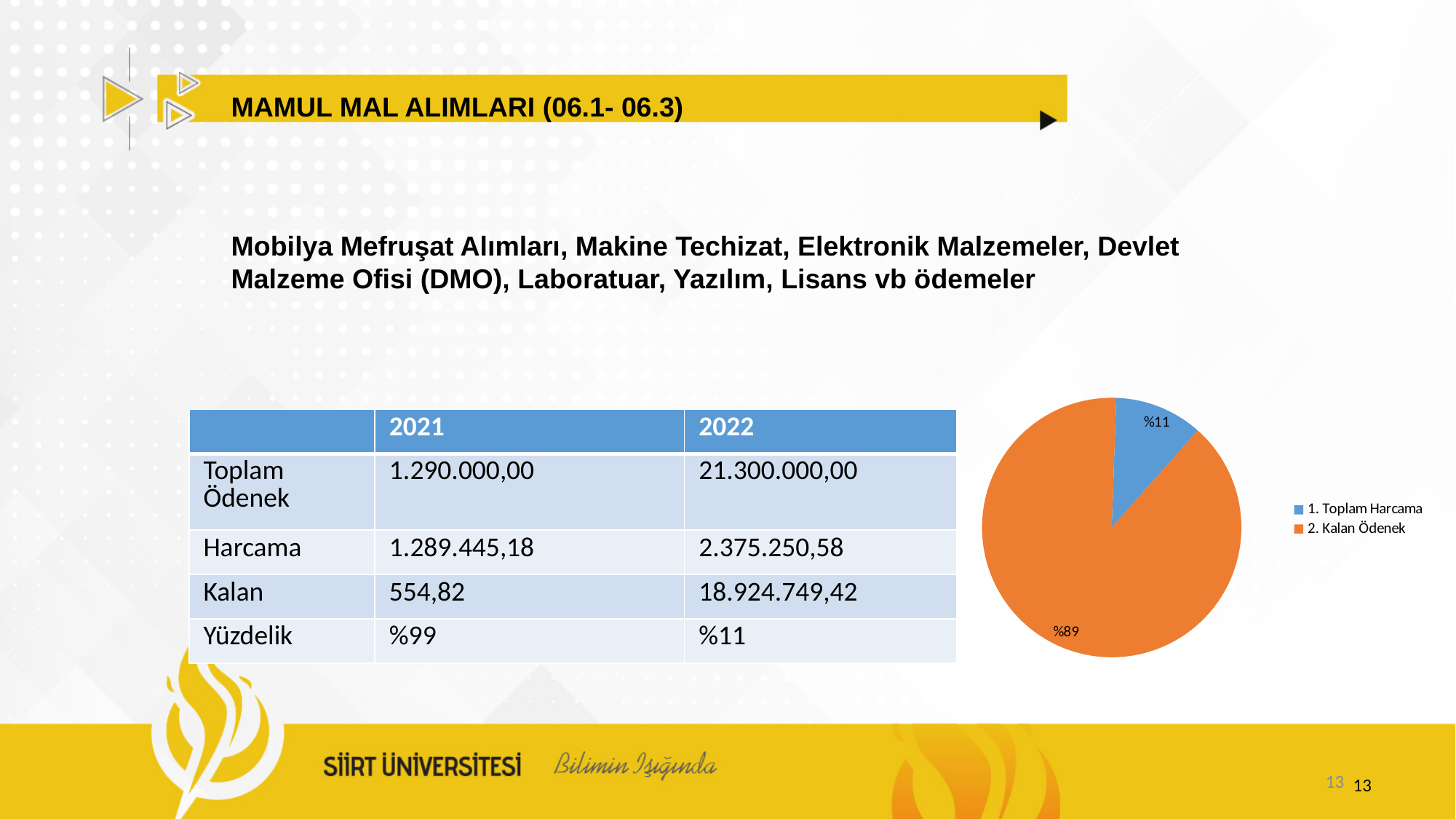
What share of the pie chart does "2. Kalan Ödenek" represent? %89 Which slice of the pie chart is the largest? 2. Kalan Ödenek What is the difference in percentage points between the "2. Kalan Ödenek" slice and the "1. Toplam Harcama" slice? 78 Which slice of the pie chart is the smallest? 1. Toplam Harcama What share of the pie chart does "1. Toplam Harcama" represent? %11 What colour is the "2. Kalan Ödenek" slice in the pie chart? orange How many slices does the pie chart have? 2 What kind of chart is shown on the slide? pie chart How many entries does the pie chart's legend list? 2 What colour is the "1. Toplam Harcama" slice in the pie chart? blue Which is larger in the pie chart, "1. Toplam Harcama" or "2. Kalan Ödenek"? 2. Kalan Ödenek